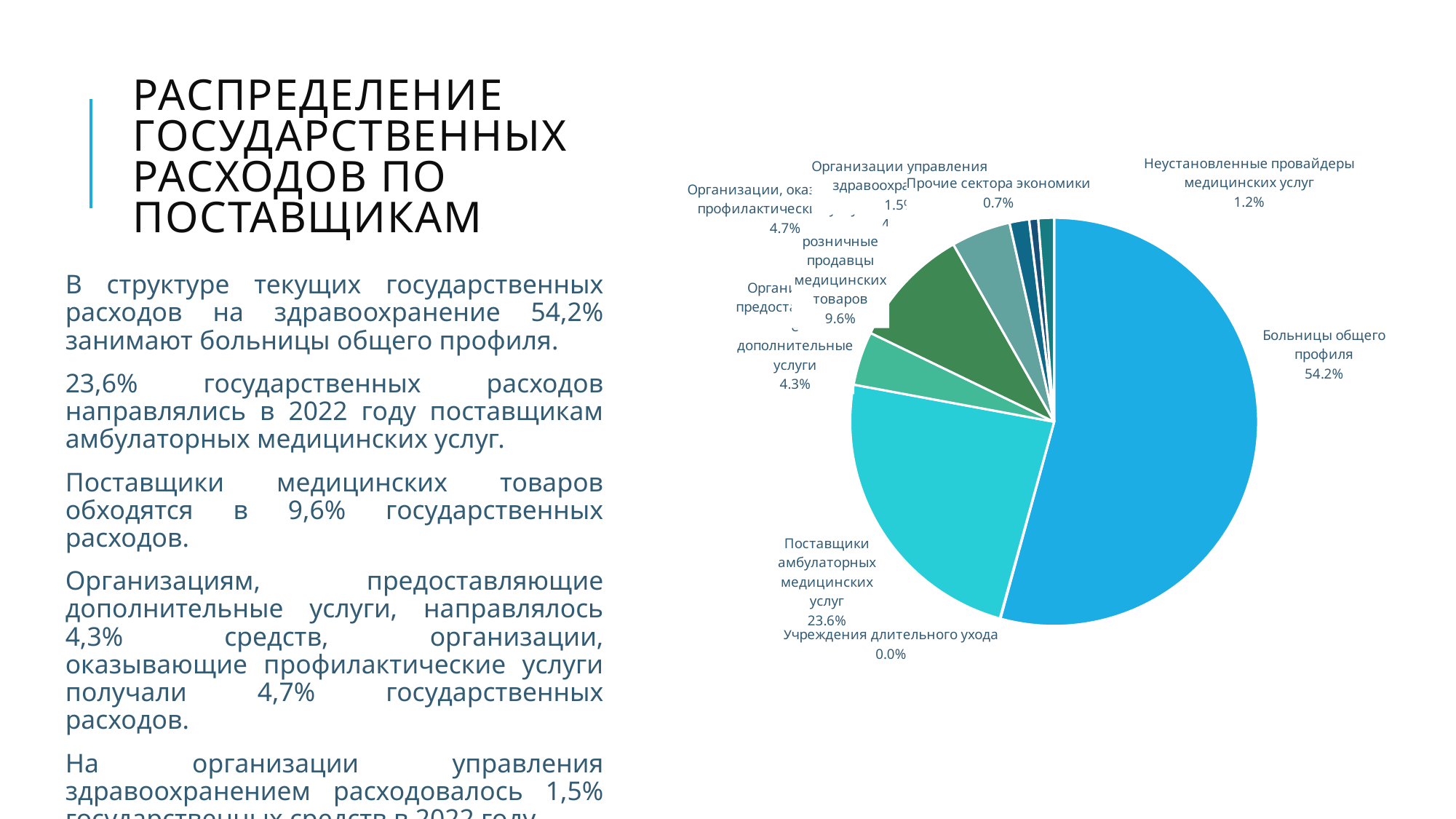
What is the value shown for "Поставщики амбулаторных медицинских услуг"? 23.6% What share of the pie does "Больницы общего профиля" take? 54.2% Which category has the largest slice of the pie? Больницы общего профиля What is the value shown for "Учреждения длительного ухода"? 0.0% What kind of chart is shown on the slide? Pie chart What is the value shown for "Неустановленные провайдеры медицинских услуг"? 1.2% Which category has the smallest slice of the pie? Учреждения длительного ухода What is the difference between the shares of "Больницы общего профиля" and "Поставщики амбулаторных медицинских услуг"? 30.6% Which is larger: the share for "Неустановленные провайдеры медицинских услуг" or for "Прочие сектора экономики"? Неустановленные провайдеры медицинских услуг What is the value shown for the retail sellers of medical goods ("розничные продавцы медицинских товаров")? 9.6% How many categories (slices) are shown in the pie chart? 9 What is the value shown for "Прочие сектора экономики"? 0.7%